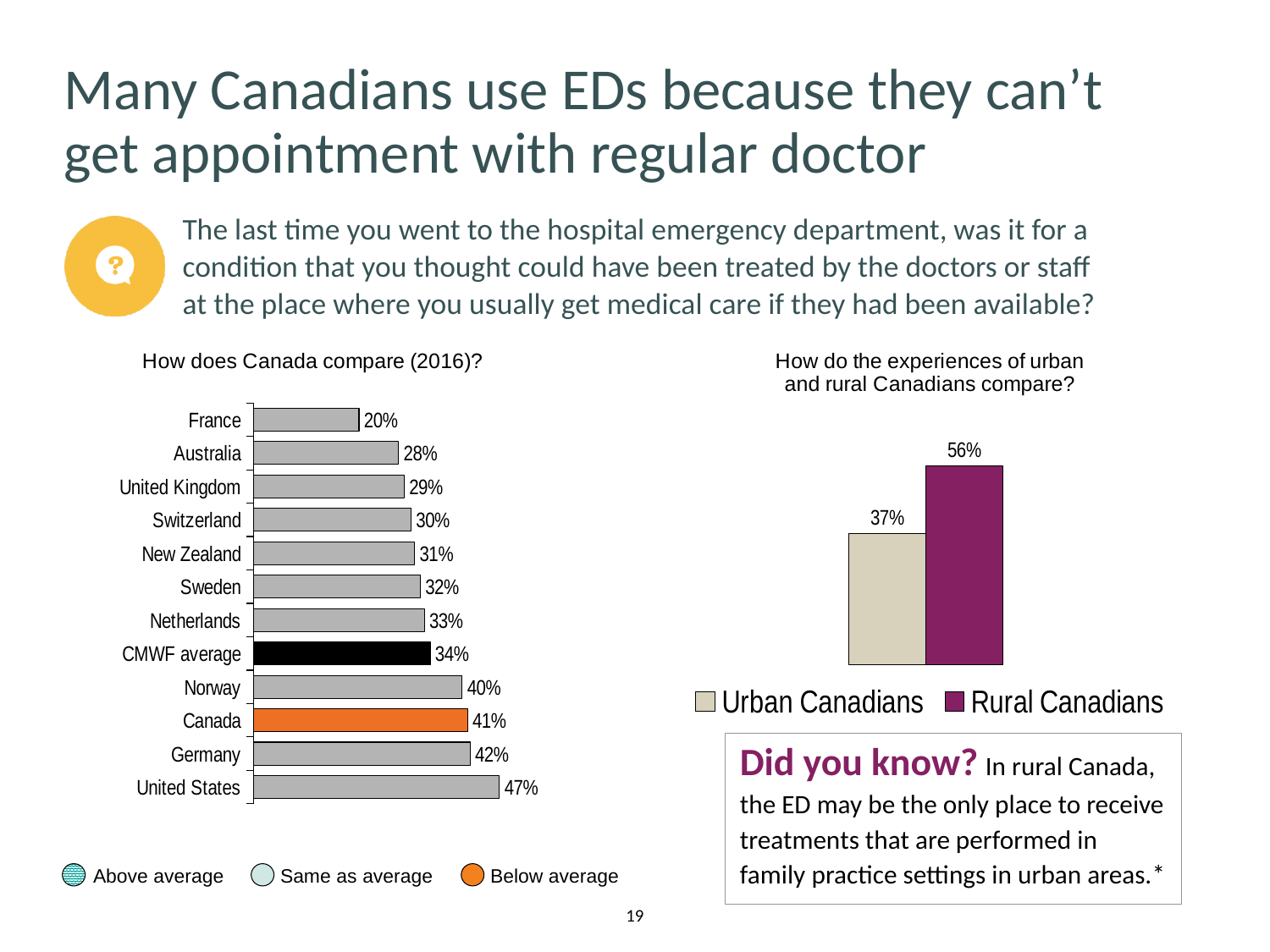
What kind of chart is the 'How does Canada compare (2016)?' chart? Bar chart In the 'How does Canada compare (2016)?' chart, what is the value for the CMWF average? 34% In the 'How does Canada compare (2016)?' chart, which is larger, the value for Norway or the value for Sweden? Norway In the 'How does Canada compare (2016)?' chart, which country has the highest value? United States In the 'How does Canada compare (2016)?' chart, what is the difference between the United States and France? 27% In the 'How does Canada compare (2016)?' chart, how many countries or categories are shown? 12 In the 'How does Canada compare (2016)?' chart, which country has the lowest value? France In the 'How do the experiences of urban and rural Canadians compare?' chart, what is the difference between Rural Canadians and Urban Canadians? 19% In the 'How does Canada compare (2016)?' chart, what is the value for Canada? 41% In the 'How do the experiences of urban and rural Canadians compare?' chart, what is the value for Rural Canadians? 56% In the 'How does Canada compare (2016)?' chart, what colour is the bar for Canada? Orange How many series does the legend of the 'How do the experiences of urban and rural Canadians compare?' chart list? 2